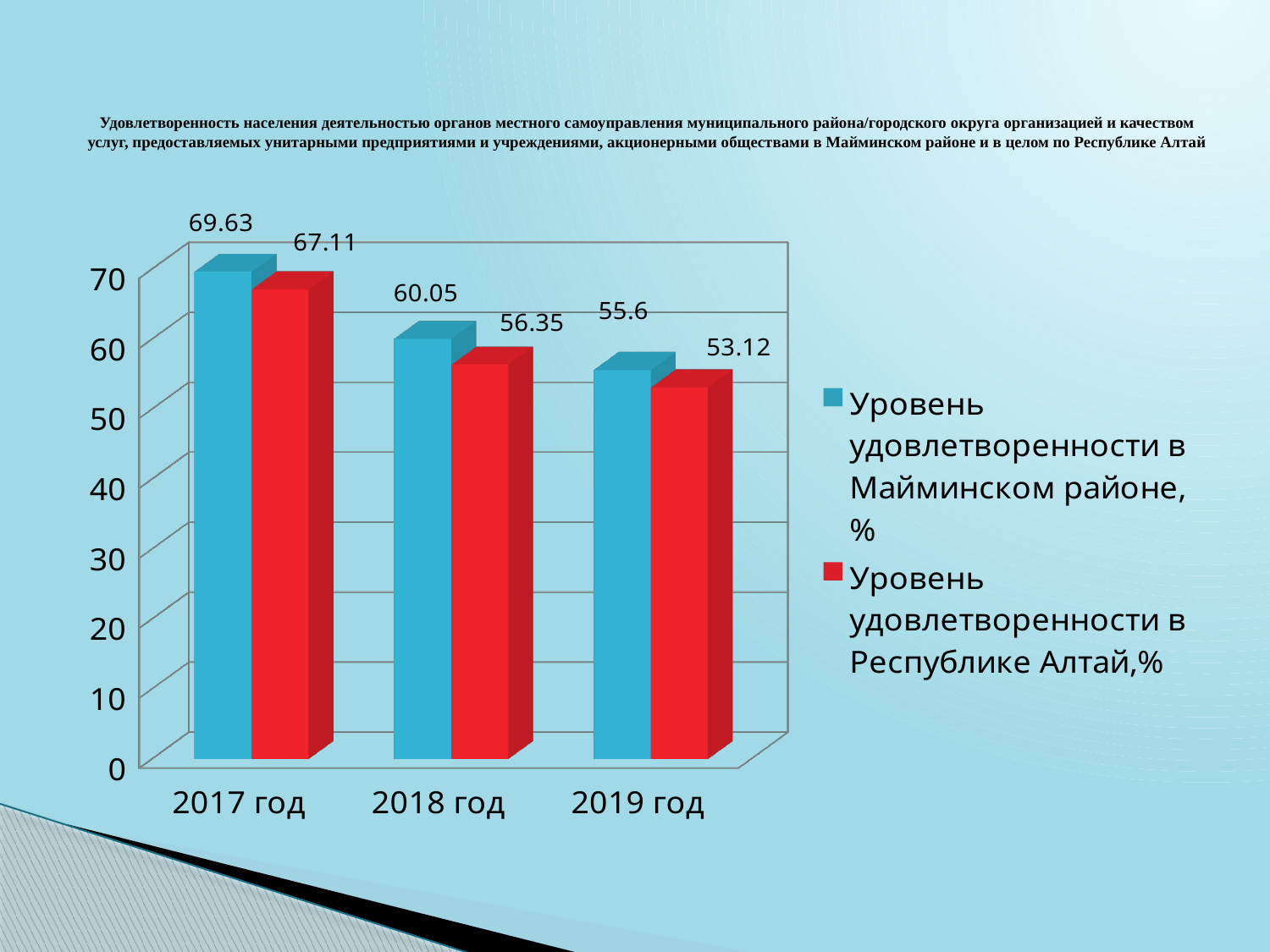
What is the value for Уровень удовлетворенности в Республике Алтай,% in 2019 год? 53.12 What is the difference between Уровень удовлетворенности в Майминском районе, % and Уровень удовлетворенности в Республике Алтай,% in 2018 год? 3.7 Do the values for Уровень удовлетворенности в Майминском районе, % rise or fall from 2017 год to 2019 год? fall In which year is Уровень удовлетворенности в Майминском районе, % highest? 2017 год What is the value for Уровень удовлетворенности в Республике Алтай,% in 2018 год? 56.35 What kind of chart is shown on the slide? bar chart How many years are shown on the x axis? 3 What is the value for Уровень удовлетворенности в Майминском районе, % in 2017 год? 69.63 How many series does the legend list? 2 In which year is Уровень удовлетворенности в Республике Алтай,% lowest? 2019 год Is the value for Уровень удовлетворенности в Майминском районе, % in 2019 год greater or less than 60? less Which is larger in 2019 год: Уровень удовлетворенности в Майминском районе, % or Уровень удовлетворенности в Республике Алтай,%? Уровень удовлетворенности в Майминском районе, %